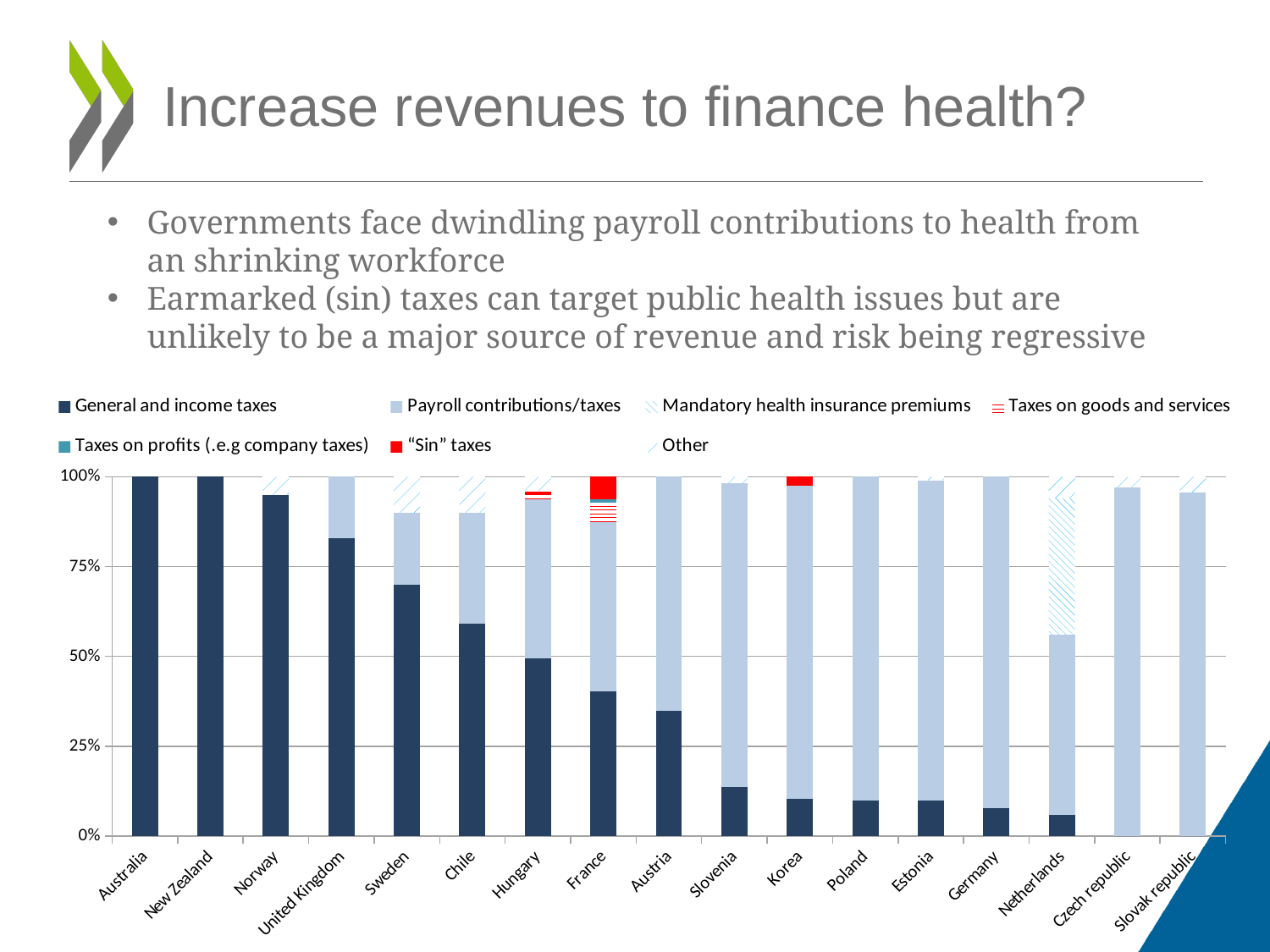
How many countries are shown on the x axis of the chart? 17 Is the share of General and income taxes for Sweden greater or less than 50%? greater Which country has the larger share of General and income taxes, Sweden or Chile? Sweden What kind of chart is shown on the slide? Stacked bar chart Which country is the only one showing a Mandatory health insurance premiums segment? Netherlands Which series is shown in red in the chart? "Sin" taxes How many series does the chart's legend list? 7 Is the share of General and income taxes for Slovenia greater or less than 25%? less Is the share of General and income taxes for France greater or less than 50%? less What share of health revenue comes from General and income taxes in Australia? 100% Moving from left to right across the countries, does the share of General and income taxes generally rise or fall? Fall Which country has the larger share of General and income taxes, Norway or United Kingdom? Norway